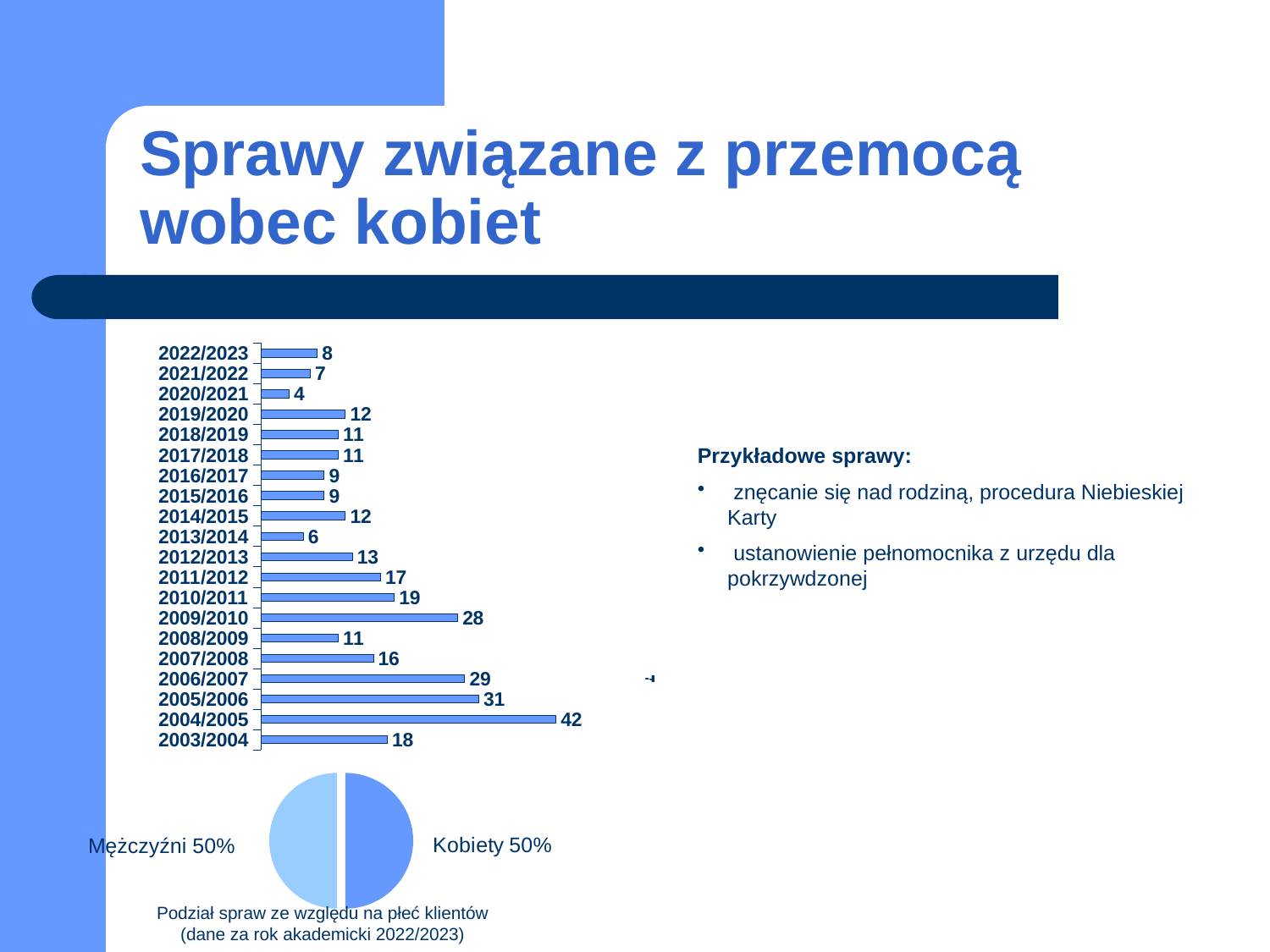
In the pie chart at the bottom of the slide, what share is labelled Kobiety? 50% In the bar chart at the top left, how many academic years are shown? 20 In the bar chart at the top left, which academic year has the highest value? 2004/2005 What kind of chart is the chart at the top left of the slide? Bar chart How many slices does the pie chart at the bottom of the slide have? 2 In the bar chart at the top left, which is larger, the value for 2010/2011 or the value for 2011/2012? 2010/2011 In the bar chart at the top left, what is the value for 2009/2010? 28 What is the caption under the pie chart at the bottom of the slide? Podział spraw ze względu na płeć klientów (dane za rok akademicki 2022/2023) In the bar chart at the top left, which academic year has the lowest value? 2020/2021 In the bar chart at the top left, what is the value for 2022/2023? 8 In the bar chart at the top left, what is the value for 2004/2005? 42 In the bar chart at the top left, what is the difference between the values for 2005/2006 and 2006/2007? 2